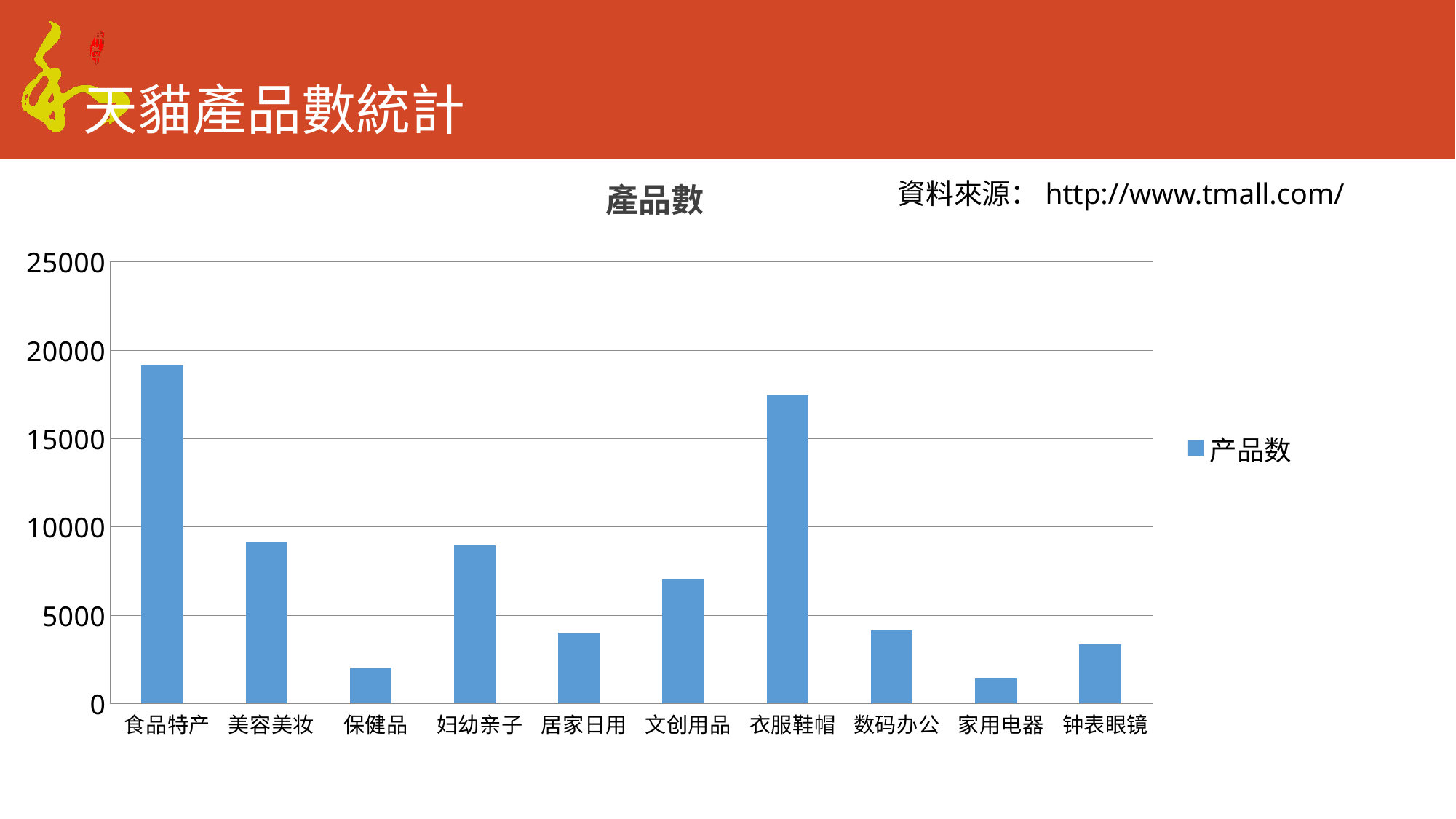
Is the value for 美容美妆 greater or less than 10000? less Is the value for 保健品 greater or less than 5000? less Which is larger, the value for 居家日用 or the value for 文创用品? 文创用品 How many categories are shown on the x axis? 10 What is the title of the chart? 產品數 What kind of chart is shown on the slide? bar chart Which is larger, the value for 衣服鞋帽 or the value for 美容美妆? 衣服鞋帽 How many series does the legend list? 1 Is the value for 食品特产 greater or less than 15000? greater Which category has the highest value? 食品特产 Which category has the lowest value? 家用电器